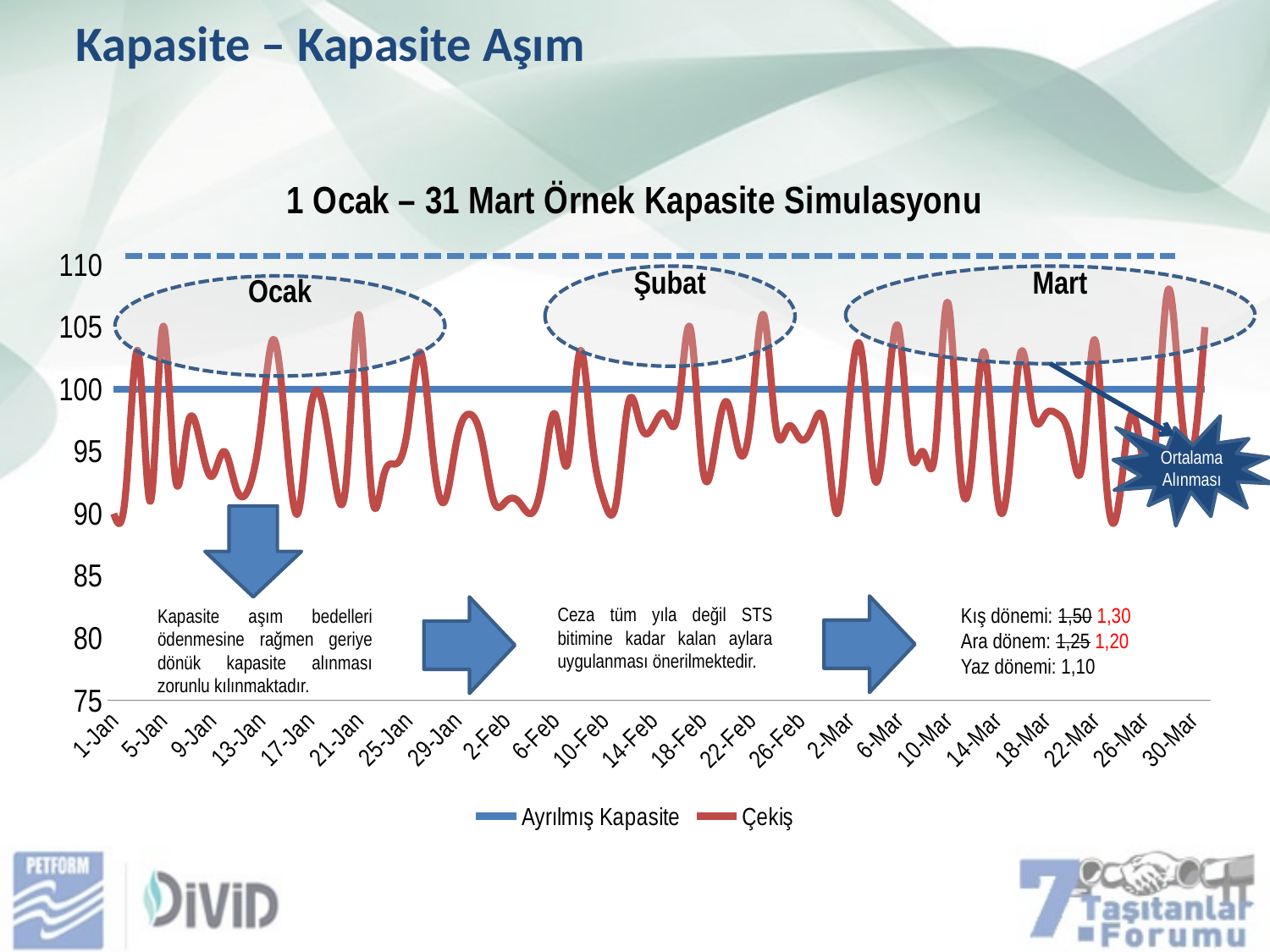
What is the highest value shown on the y axis? 110 What colour is the Çekiş line? red Is the highest Çekiş peak near 26-Mar greater or less than 105? greater What is the value of the Ayrılmış Kapasite line? 100 How many date labels are shown on the x axis? 23 In which month does the Çekiş line reach its highest peak? Mart Is the Çekiş value on 1-Jan greater or less than 95? less Does the Ayrılmış Kapasite line rise, fall or stay flat across the x axis? stays flat What is the title of the chart? 1 Ocak – 31 Mart Örnek Kapasite Simulasyonu What kind of chart is shown on the slide? line chart On 1-Jan, which is larger: Ayrılmış Kapasite or Çekiş? Ayrılmış Kapasite How many series does the legend list? 2